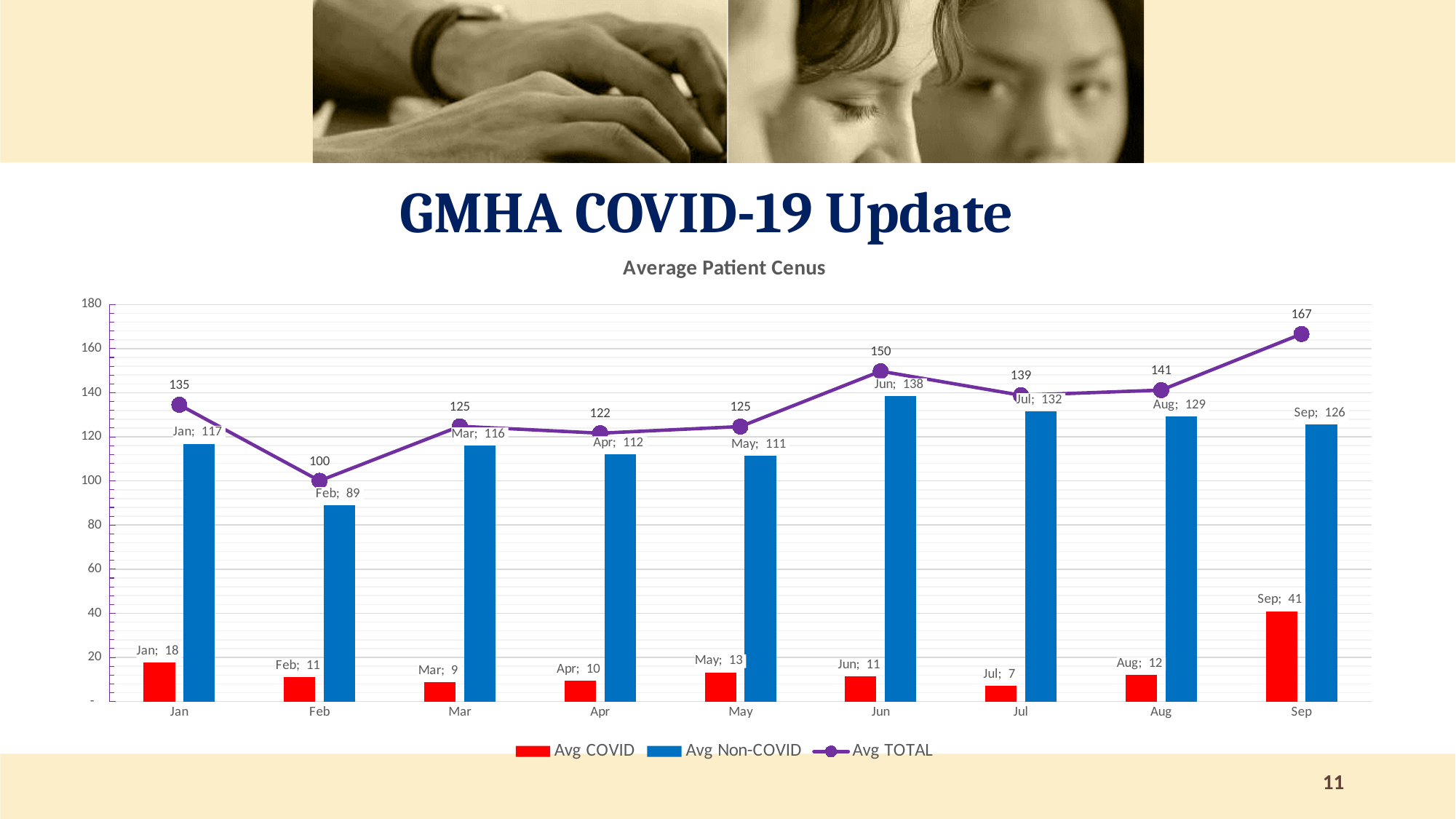
What is the Avg COVID value for Sep? 41 What is the title of the chart? Average Patient Cenus Which is larger, the Avg COVID value for Jan or for May? Jan What is the Avg TOTAL value for Jun? 150 Which month has the highest Avg TOTAL? Sep Does the Avg TOTAL line rise or fall from Jul to Sep? Rise How many months are shown on the x axis? 9 What is the Avg Non-COVID value for Feb? 89 How many series does the legend list? 3 What is the difference between the Avg Non-COVID values for Jun and Feb? 49 Which month has the lowest Avg COVID value? Jul What kind of chart is used for the Avg COVID and Avg Non-COVID series? Bar chart